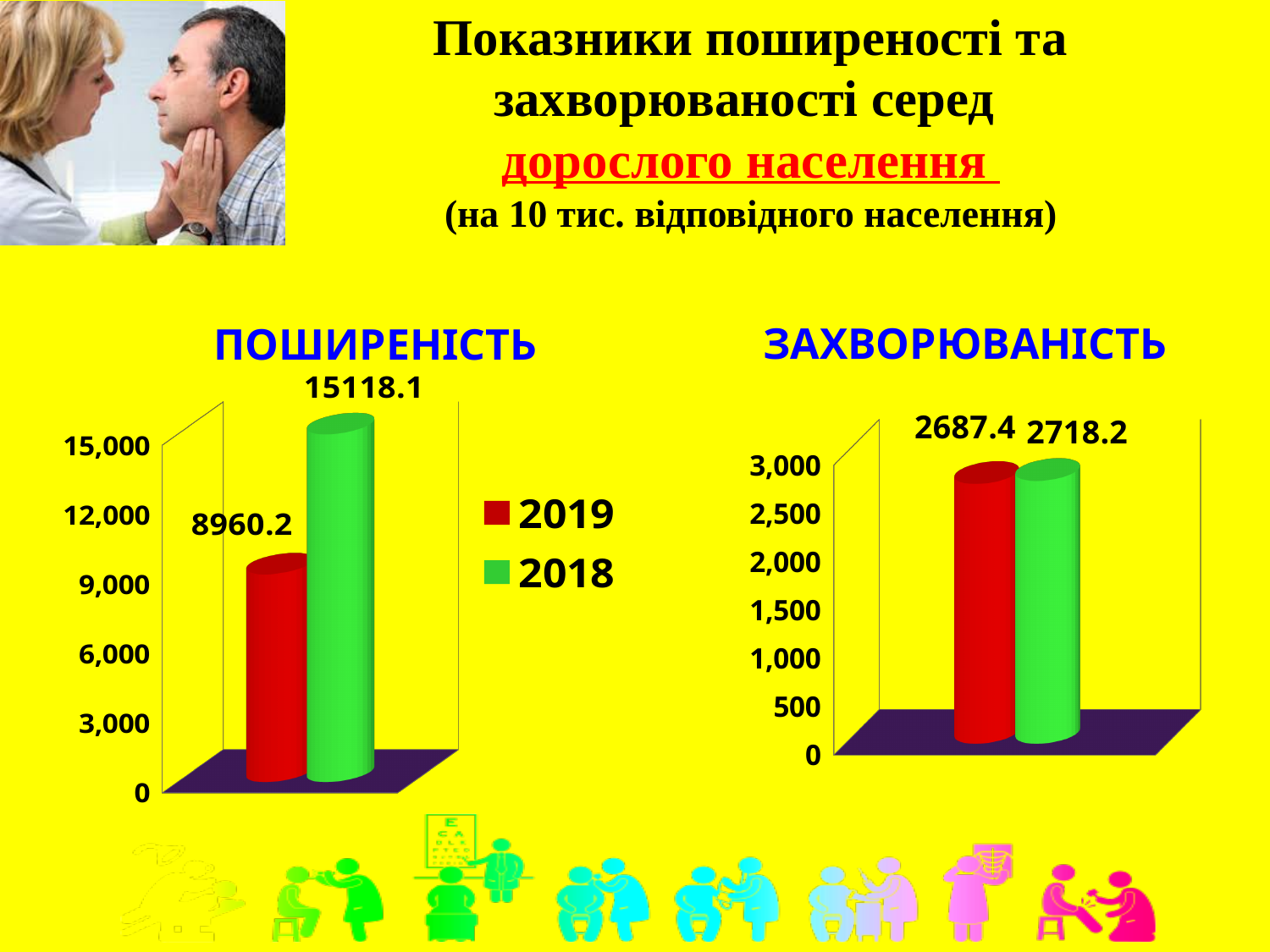
In the ЗАХВОРЮВАНІСТЬ chart, is the value for 2018 larger or smaller than the value for 2019? larger In the ЗАХВОРЮВАНІСТЬ chart, what is the value for 2018? 2718.2 In the ЗАХВОРЮВАНІСТЬ chart, what is the difference between the 2018 and 2019 values? 30.8 In the ПОШИРЕНІСТЬ chart, what is the value for 2018? 15118.1 In the ПОШИРЕНІСТЬ chart, is the value for 2019 greater or less than 12,000? less How many series does the legend list? 2 In the ПОШИРЕНІСТЬ chart, what is the value for 2019? 8960.2 What kind of chart is the ЗАХВОРЮВАНІСТЬ chart? bar chart In the ЗАХВОРЮВАНІСТЬ chart, which year has the lower value? 2019 In the ПОШИРЕНІСТЬ chart, which year has the higher value? 2018 In the ЗАХВОРЮВАНІСТЬ chart, what is the value for 2019? 2687.4 In the ПОШИРЕНІСТЬ chart, what is the difference between the 2018 and 2019 values? 6157.9